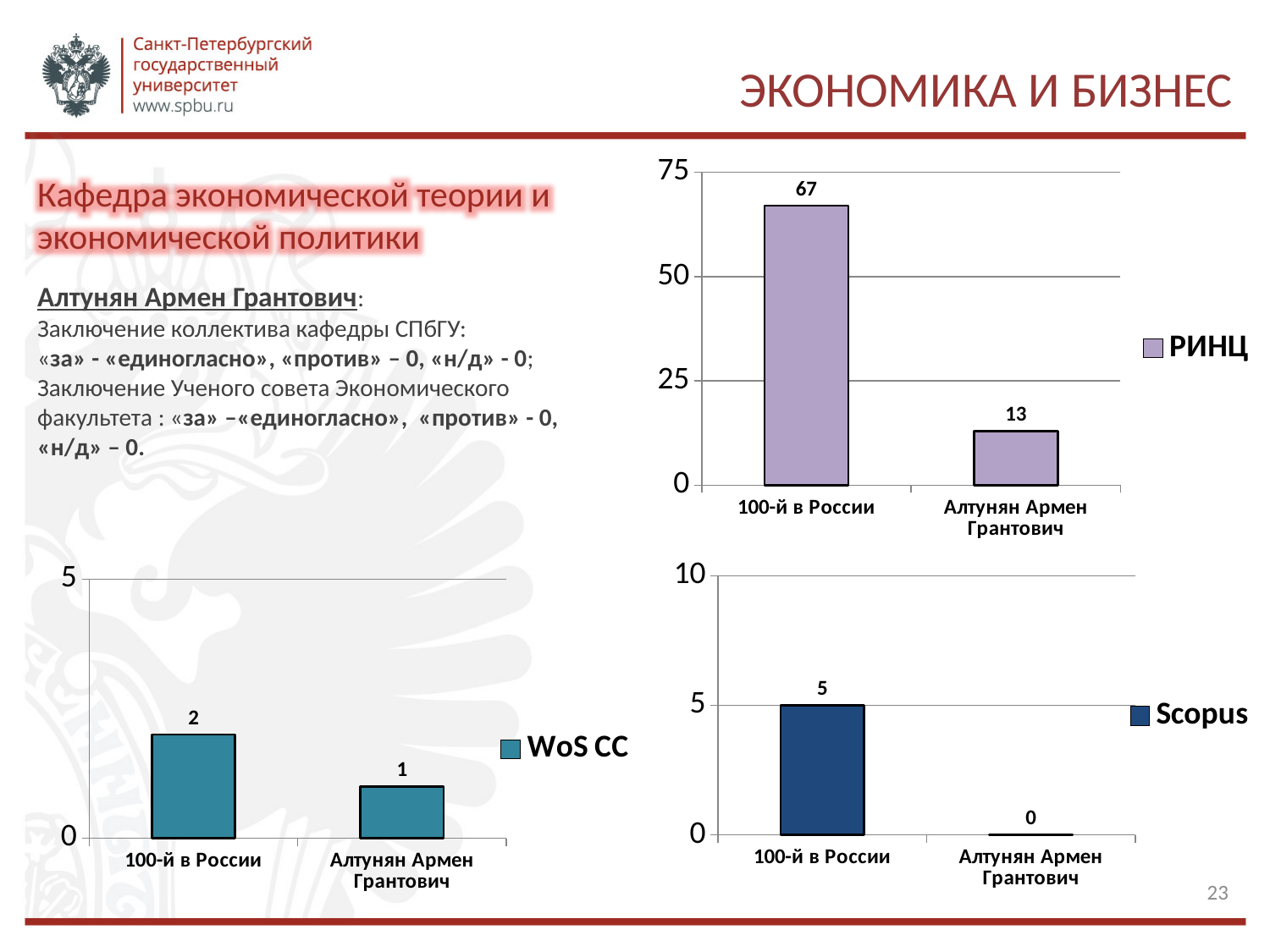
In the Scopus chart, what is the value for Алтунян Армен Грантович? 0 In the WoS CC chart, which category has the lowest value? Алтунян Армен Грантович In the WoS CC chart, what is the value for Алтунян Армен Грантович? 1 What kind of chart is the WoS CC chart? bar chart In the WoS CC chart, what is the value for 100-й в России? 2 In the Scopus chart, which category has the highest value? 100-й в России In the Scopus chart, what is the value for 100-й в России? 5 In the РИНЦ chart, what is the value for 100-й в России? 67 In the РИНЦ chart, what is the difference between the values for 100-й в России and Алтунян Армен Грантович? 54 In the РИНЦ chart, what is the value for Алтунян Армен Грантович? 13 How many categories are shown in the Scopus chart? 2 In the РИНЦ chart, is the value for 100-й в России greater or less than 50? greater